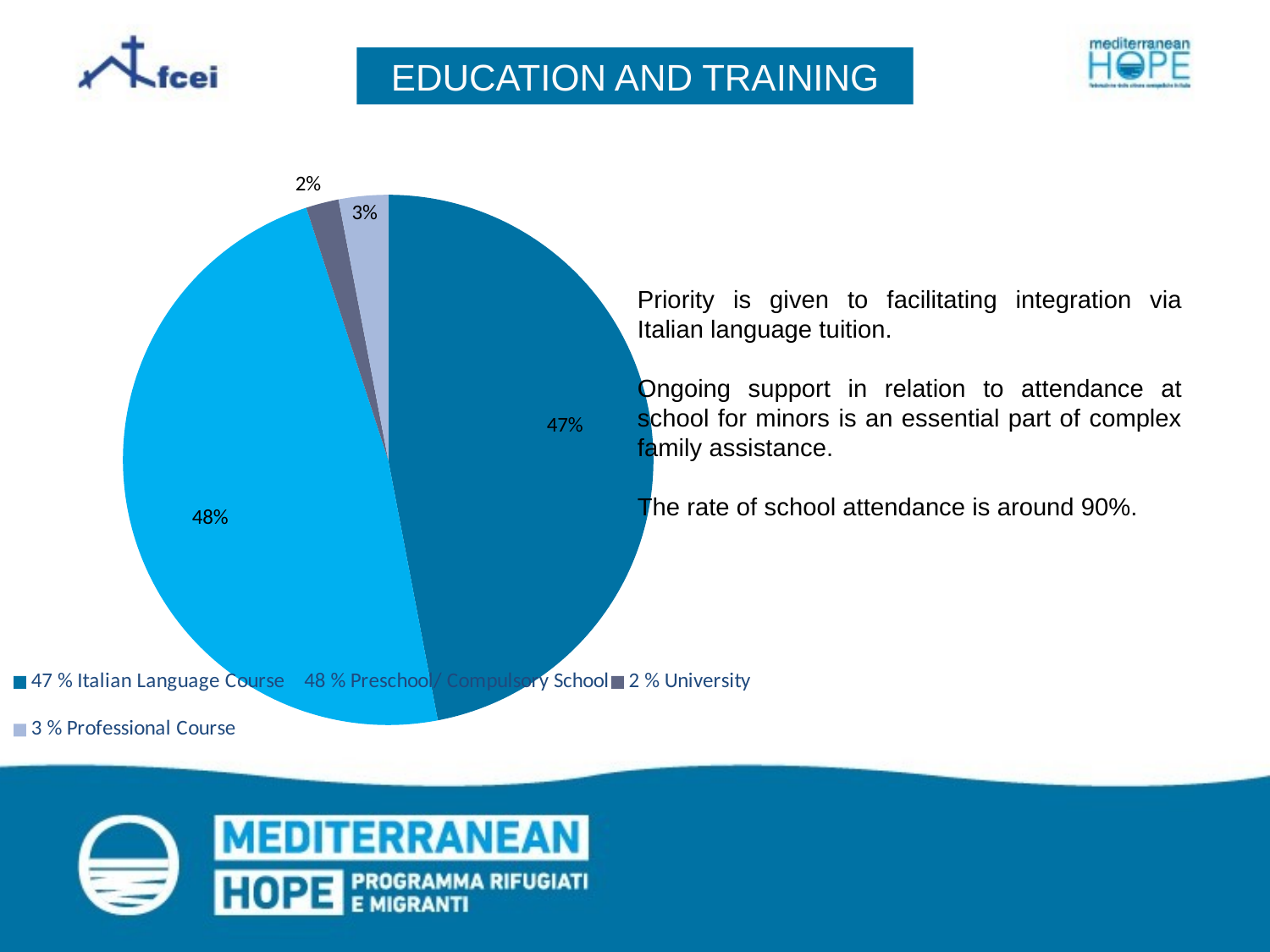
How many slices does the pie chart have? 4 Which category has the smallest slice of the pie? University What kind of chart is shown on the slide? pie chart What share of the pie does the Italian Language Course slice represent? 47% What is the difference in percentage points between the Italian Language Course slice and the University slice? 45 What share of the pie does the University slice represent? 2% What share of the pie does the Professional Course slice represent? 3% Which category has the largest slice of the pie? Preschool/Compulsory School What is the difference in percentage points between the Preschool/Compulsory School slice and the Italian Language Course slice? 1 Which slice is larger, Professional Course or University? Professional Course How many entries does the chart legend list? 4